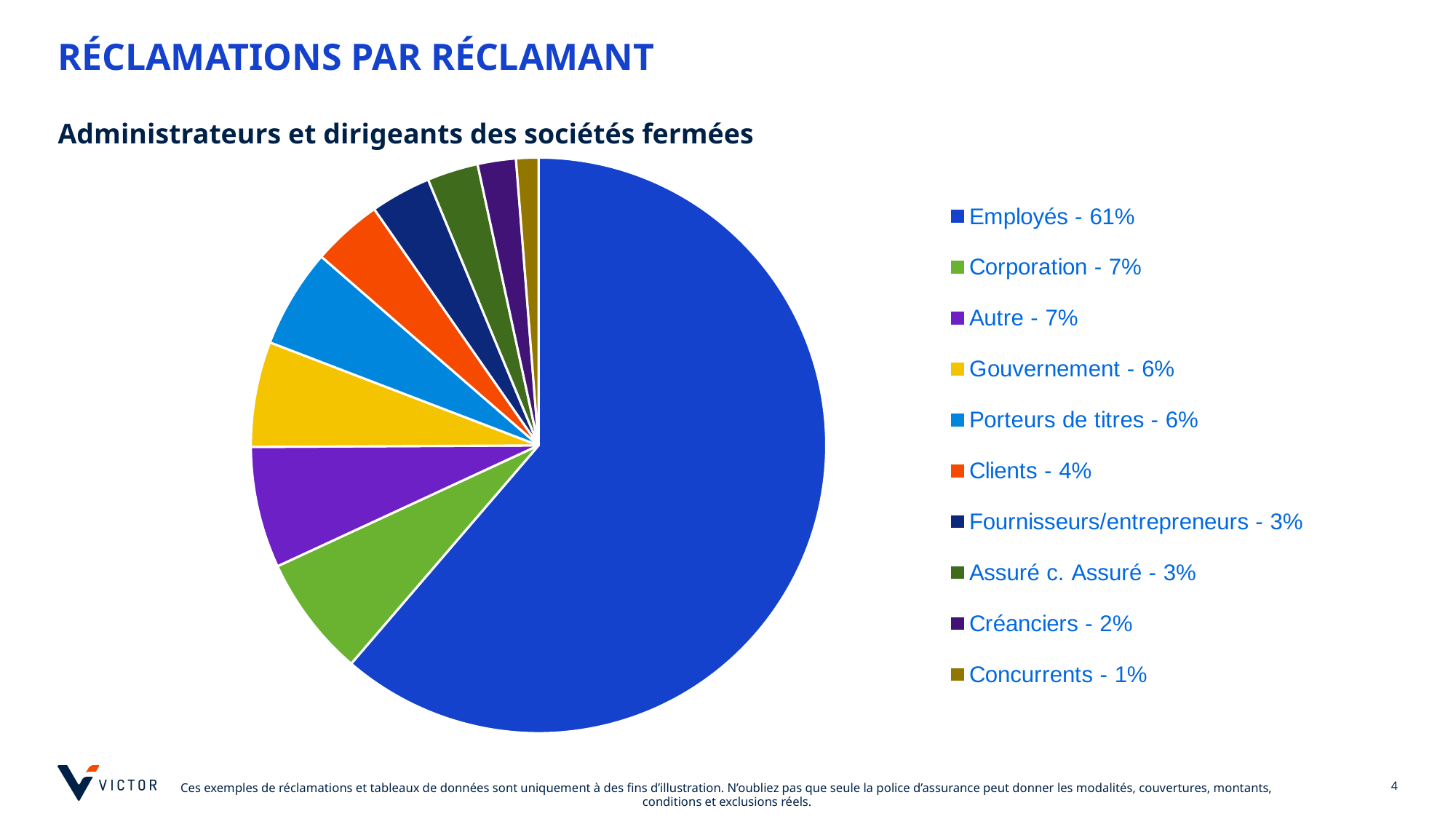
How many claimant categories are shown in the pie chart? 10 What is the subtitle shown above the chart? Administrateurs et dirigeants des sociétés fermées What type of chart is shown on the slide? Pie chart Which has a larger share, Porteurs de titres or Créanciers? Porteurs de titres What is the difference in percentage points between Employés and Corporation? 54 Which claimant category has the largest share of claims? Employés Which claimant category has the smallest share of claims? Concurrents What percentage of claims comes from Gouvernement? 6% Which has a larger share, Clients or Assuré c. Assuré? Clients What share of claims is attributed to Employés? 61% What is the difference in percentage points between Clients and Créanciers? 2 What is the share for Fournisseurs/entrepreneurs? 3%